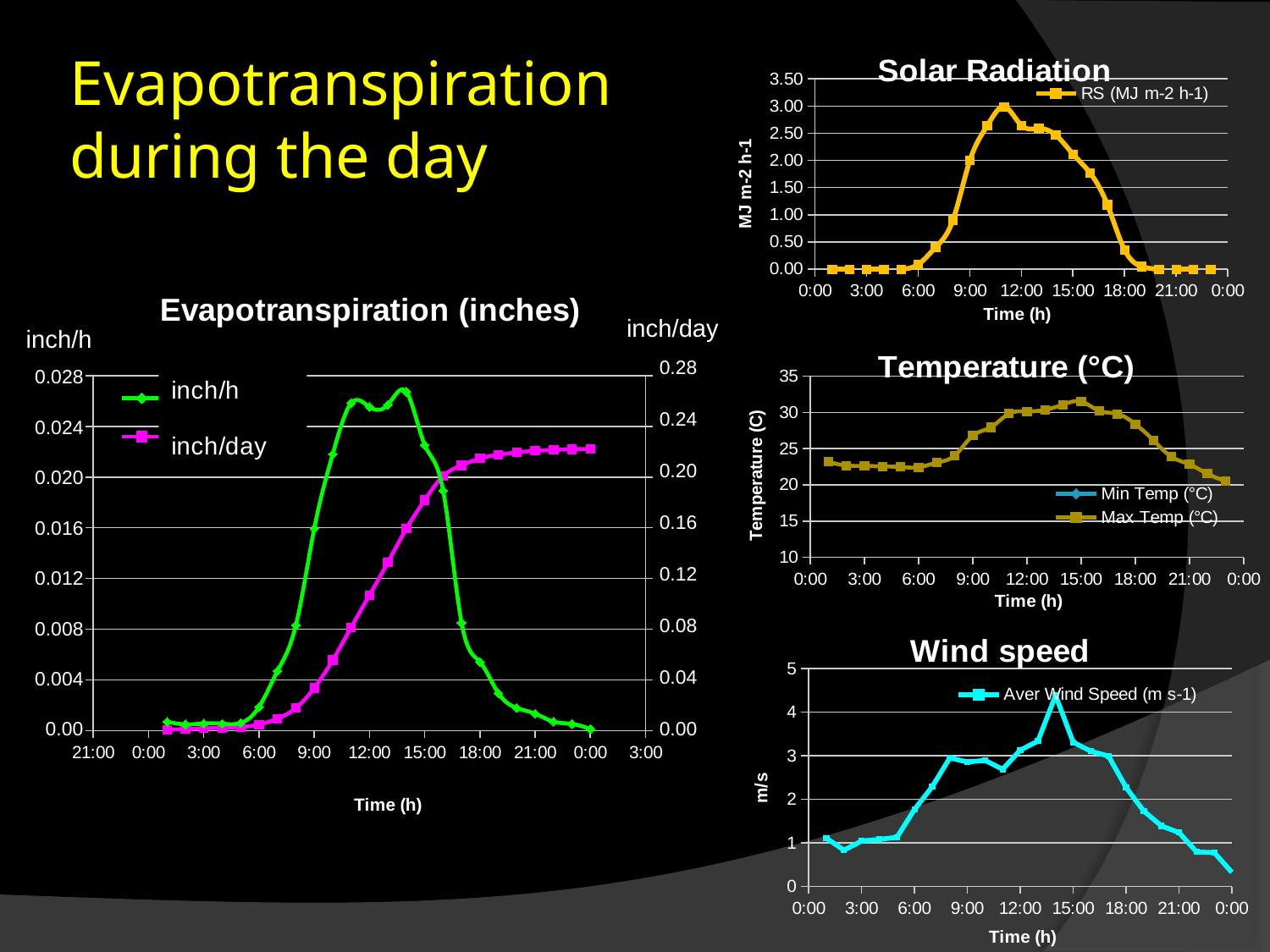
How many series does the legend of the Temperature (°C) chart list? 2 In the Solar Radiation chart, do the values rise or fall between 12:00 and 18:00? fall How many series does the legend of the Evapotranspiration (inches) chart list? 2 In the Solar Radiation chart, is the value at 3:00 greater or less than 0.50? less In the Solar Radiation chart, is the value at 12:00 greater or less than 2.00? greater In the Evapotranspiration (inches) chart, does the inch/day series rise or fall along the x axis? rise In the Temperature (°C) chart, is the Max Temp value at 3:00 greater or less than 25? less What is the legend entry shown in the Solar Radiation chart? RS (MJ m-2 h-1) What kind of chart is the Evapotranspiration (inches) chart? line chart